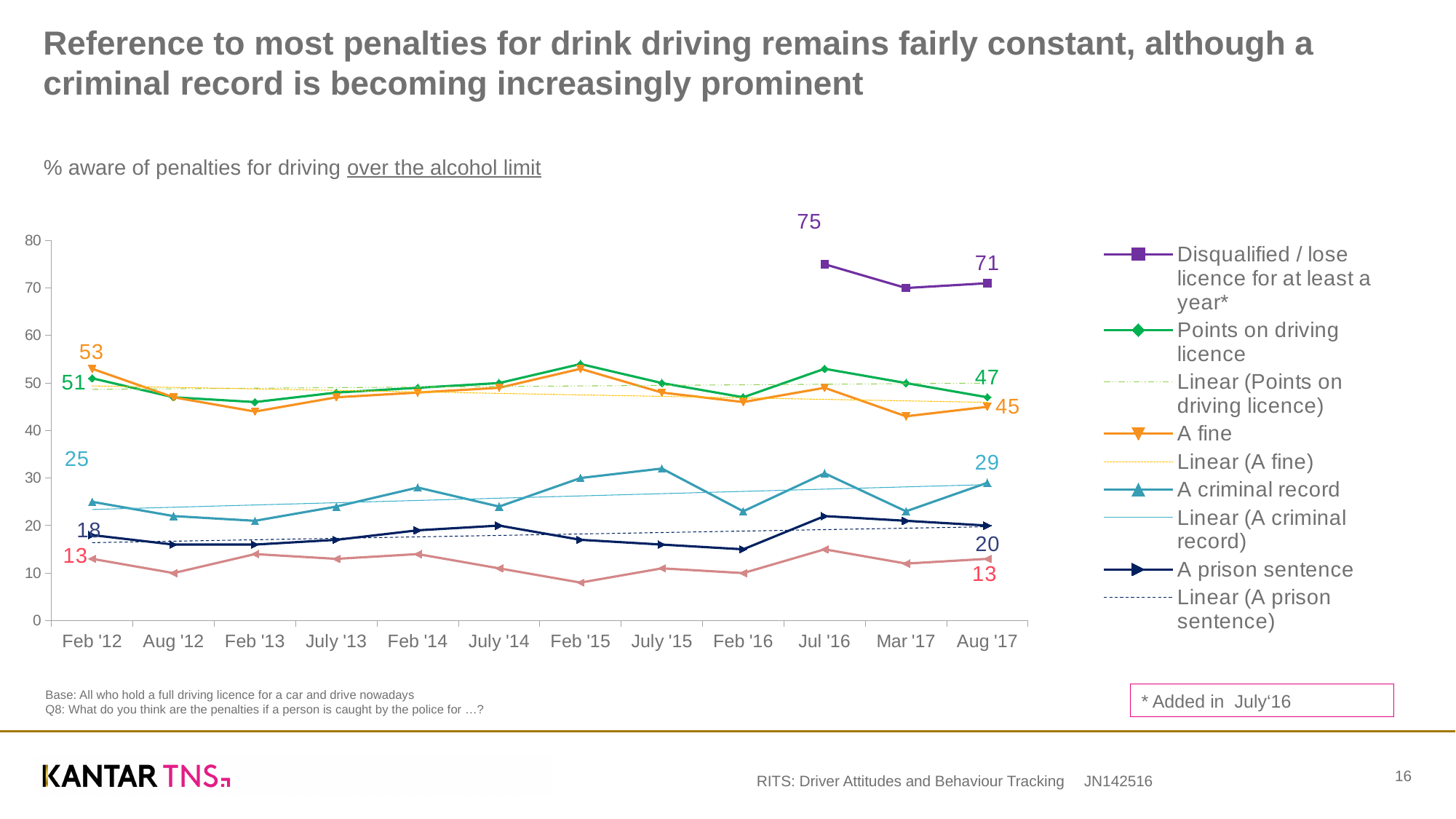
Is the value for A prison sentence in Feb '16 greater or less than 20? less What is the value for A fine in Feb '12? 53 What is the difference between the Disqualified / lose licence for at least a year values in Jul '16 and Aug '17? 4 How many entries does the legend list? 9 What is the value for Disqualified / lose licence for at least a year in Jul '16? 75 What kind of chart is shown on the slide? line chart What is the value for A prison sentence in Aug '17? 20 In Aug '17, which is larger: Points on driving licence or A fine? Points on driving licence How many time points are shown on the x axis? 12 By how much did the value for A fine fall between Feb '12 and Aug '17? 8 What is the value for A criminal record in Aug '17? 29 Which series has the highest value in Aug '17? Disqualified / lose licence for at least a year